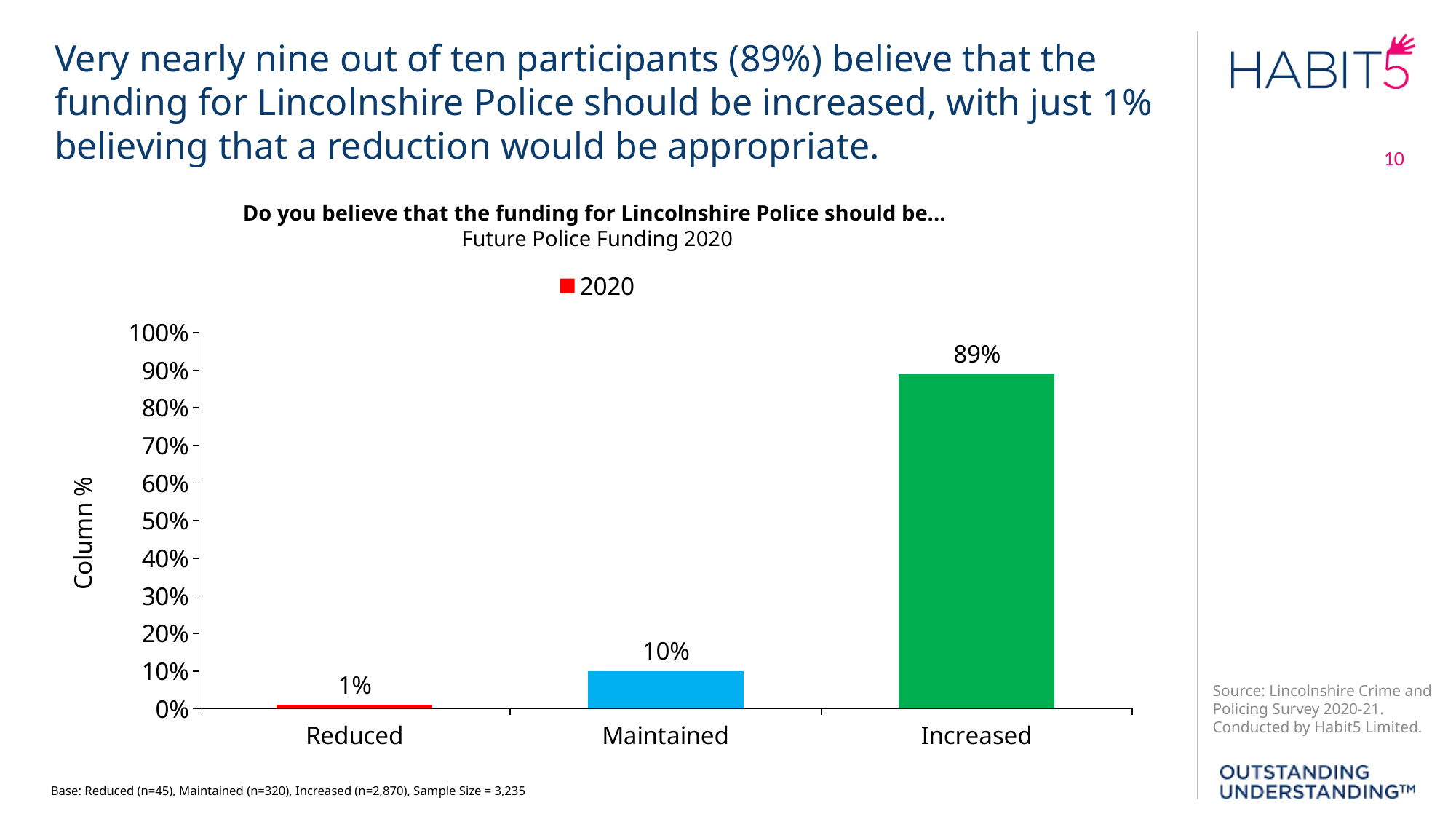
What percentage of participants believe funding should be Maintained? 10% What is the difference between the values for Maintained and Reduced? 9% What kind of chart is shown on the slide? bar chart Is the value for Increased greater or less than 80%? greater Which category has the highest value? Increased Which is larger, the value for Maintained or the value for Reduced? Maintained What percentage of participants believe funding should be Increased? 89% Which category has the lowest value? Reduced What is the label of the y axis? Column % What percentage of participants believe funding should be Reduced? 1% What is the difference between the values for Increased and Maintained? 79% How many categories are shown on the x axis? 3